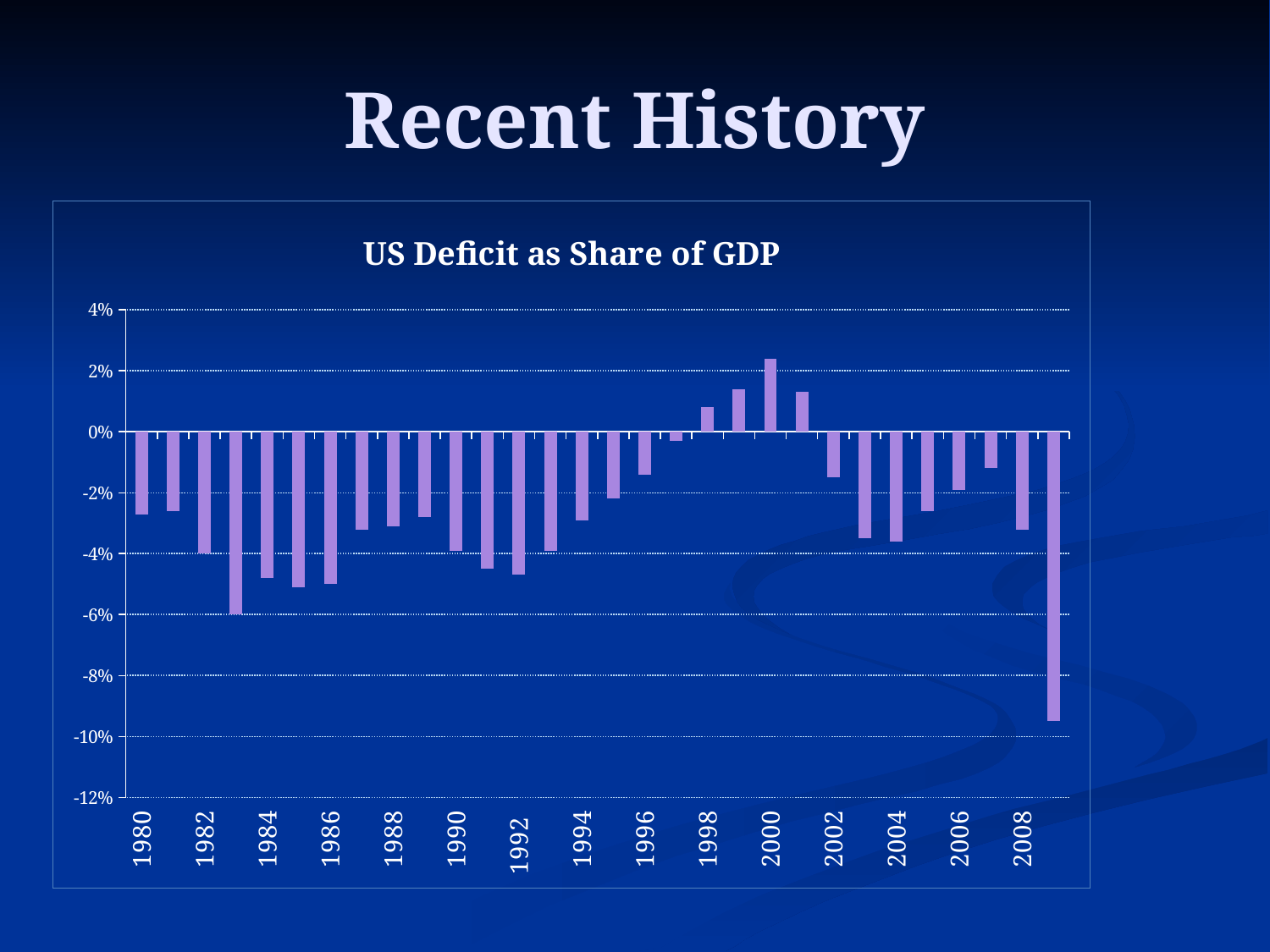
Which year has the lowest value in the chart? 2009 Is the value for 1983 greater or less than -4%? less Do the values generally rise or fall from 1992 to 2000? rise Is the value for 2000 greater or less than 2%? greater Which is larger, the value for 1980 or the value for 1983? 1980 Which year has the highest value in the chart? 2000 Is the value for 2009 greater or less than -8%? less Which is larger, the value for 1999 or the value for 2000? 2000 How many years have a positive (above 0%) value in the chart? 4 What is the title of the chart? US Deficit as Share of GDP What kind of chart is shown on the slide? bar chart